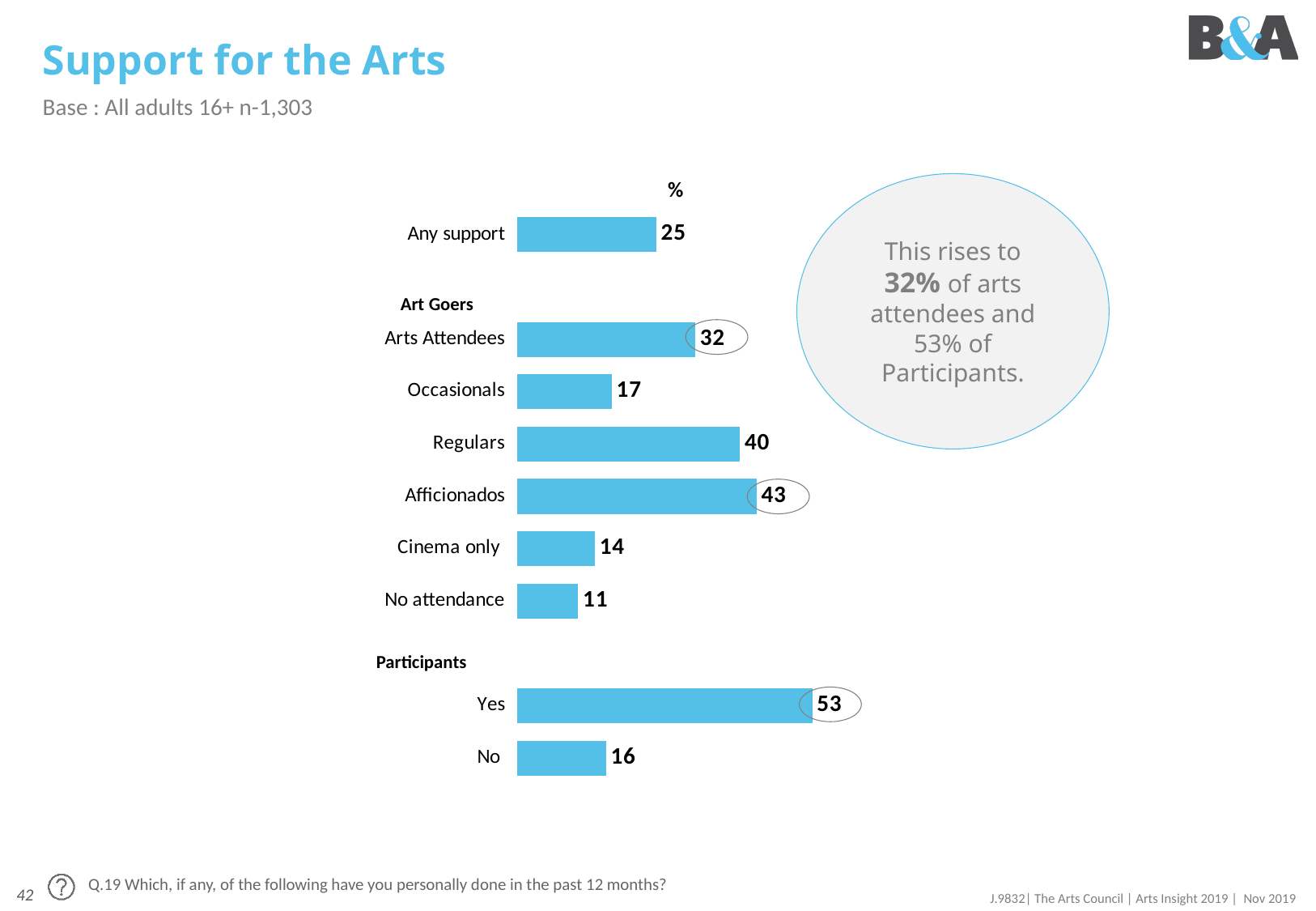
What is the title of the slide containing the chart? Support for the Arts What is the value for Afficionados? 43 What is the value for Any support? 25 Which is larger, the value for Arts Attendees or the value for Regulars? Regulars What is the difference between the values for Participants Yes and No? 37 Which category has the highest value on the chart? Yes What kind of chart is shown on the slide? Bar chart How many bars are plotted on the chart? 9 Which category has the lowest value on the chart? No attendance What is the difference between the values for Regulars and Occasionals? 23 What is the value for Participants who answered Yes? 53 What is the value for Cinema only? 14